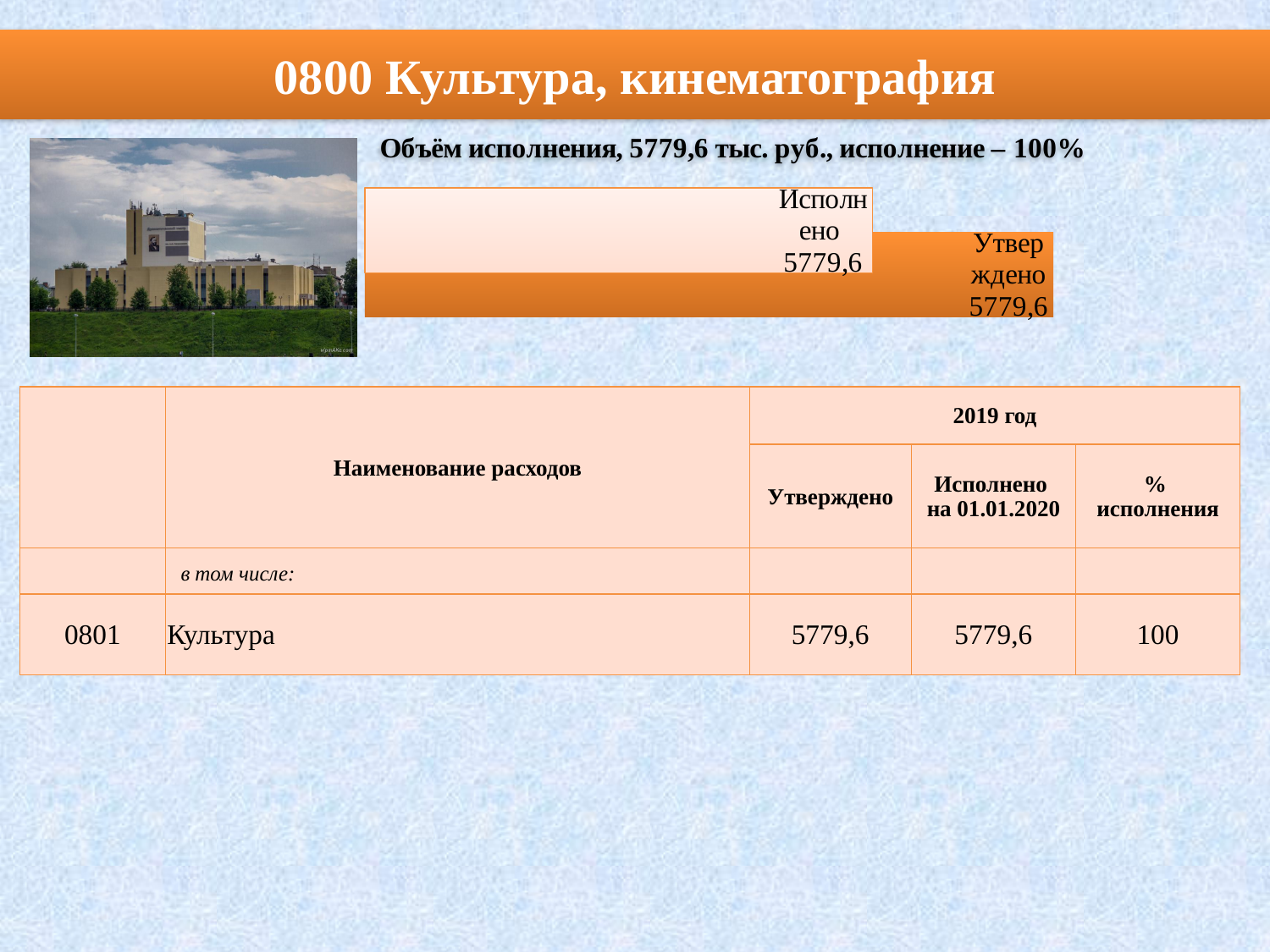
What is the difference between the Утверждено value and the Исполнено value? 0 What kind of chart is shown on the slide? bar chart How many bars does the chart contain? 2 Which bar is positioned at the top of the chart? Исполнено What colour is the bar labelled Утверждено? orange What value is shown on the bar labelled Исполнено? 5779,6 What value is shown on the bar labelled Утверждено? 5779,6